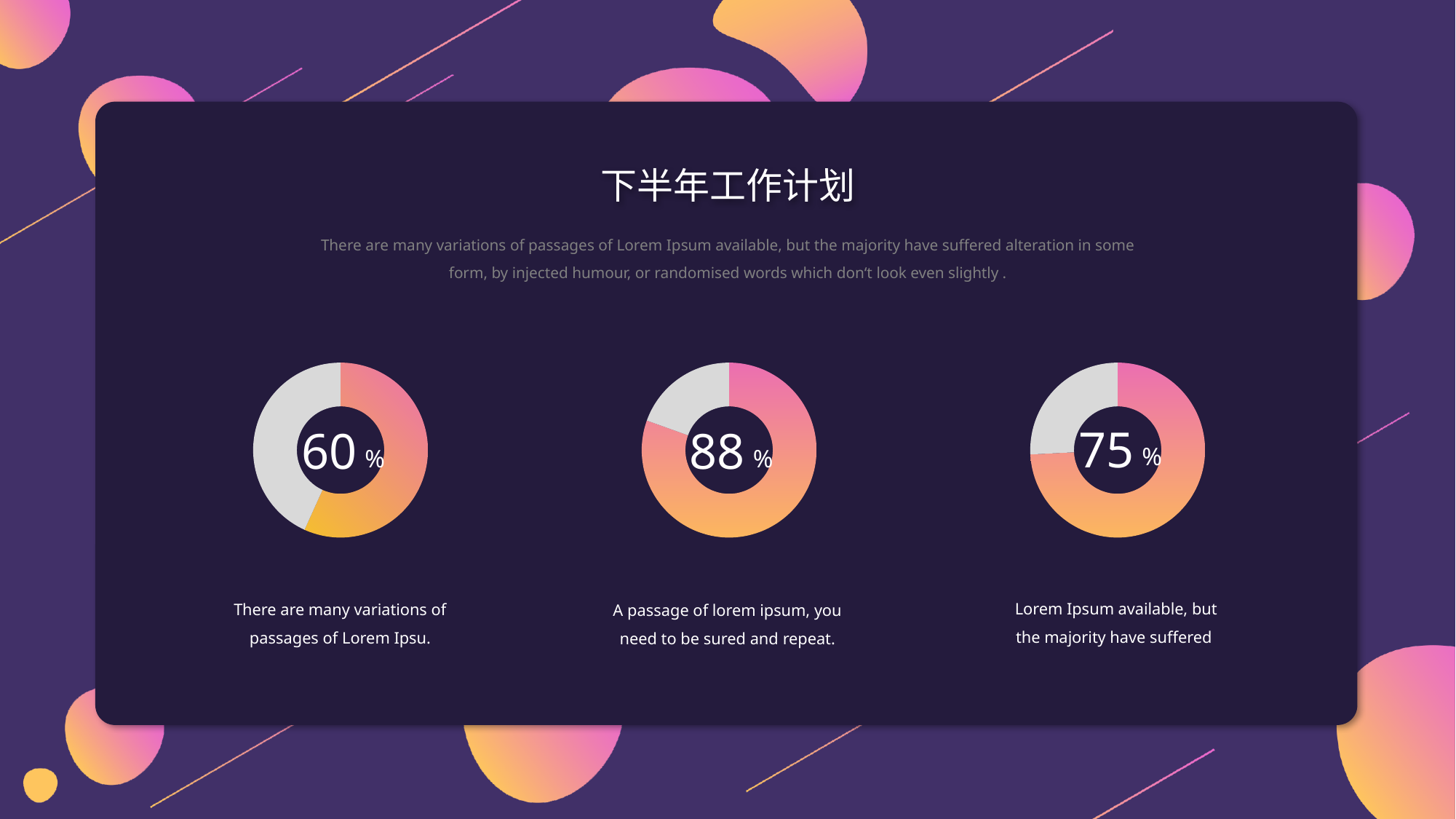
What percentage is shown in the centre of the left donut chart? 60% Which is larger, the percentage in the right donut chart or the percentage in the middle donut chart? The middle chart (88%) What is the difference in percentage points between the middle chart (88%) and the left chart (60%)? 28 How many donut charts are shown on the slide? 3 What is the title of the slide containing the three donut charts? 下半年工作计划 Which of the three donut charts shows the lowest percentage? The left chart (60%) What kind of chart is used to display the three percentages on the slide? Donut (pie) chart Which of the three donut charts shows the highest percentage? The middle chart (88%) What percentage is shown in the centre of the right donut chart? 75% What percentage is shown in the centre of the middle donut chart? 88% What is the difference in percentage points between the right chart (75%) and the left chart (60%)? 15